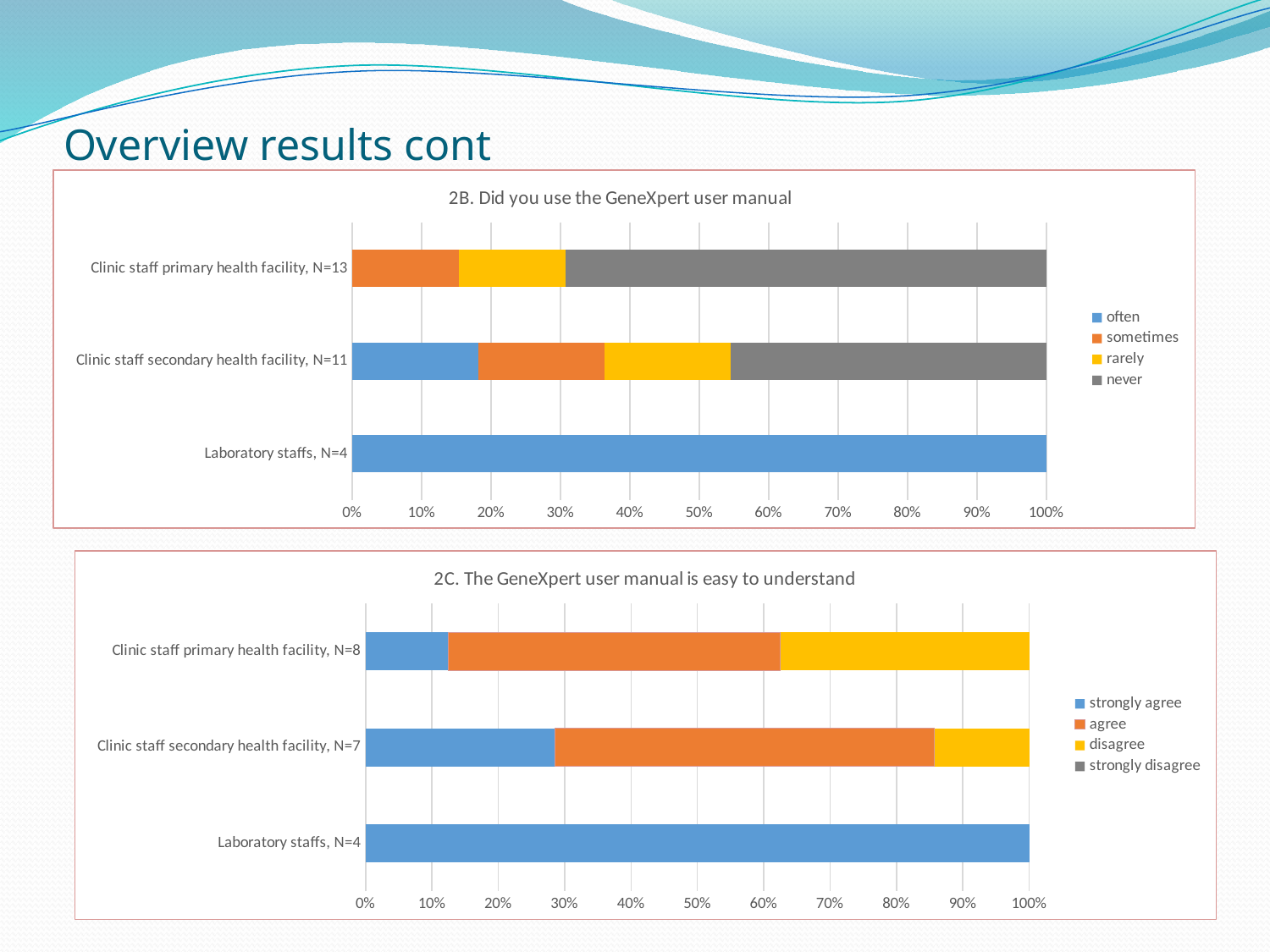
In the chart "2B. Did you use the GeneXpert user manual", is the "never" share for Clinic staff primary health facility, N=13 greater or less than 60%? greater In the chart "2B. Did you use the GeneXpert user manual", what share of Laboratory staffs, N=4 answered "often"? 100% In the chart "2C. The GeneXpert user manual is easy to understand", is the "disagree" share for Clinic staff secondary health facility, N=7 greater or less than 20%? less In the chart "2C. The GeneXpert user manual is easy to understand", what share of Laboratory staffs, N=4 answered "strongly agree"? 100% How many respondent groups (categories) are shown in the chart "2B. Did you use the GeneXpert user manual"? 3 In the chart "2C. The GeneXpert user manual is easy to understand", how many series does the legend list? 4 In the chart "2C. The GeneXpert user manual is easy to understand", which group has the larger "strongly agree" share: Clinic staff primary health facility, N=8 or Clinic staff secondary health facility, N=7? Clinic staff secondary health facility, N=7 What kind of chart is used for "2B. Did you use the GeneXpert user manual"? Stacked bar chart What are the legend entries of the chart "2C. The GeneXpert user manual is easy to understand"? strongly agree, agree, disagree, strongly disagree In the chart "2B. Did you use the GeneXpert user manual", is the "never" share for Clinic staff secondary health facility, N=11 greater or less than 40%? greater In the chart "2B. Did you use the GeneXpert user manual", how many series does the legend list? 4